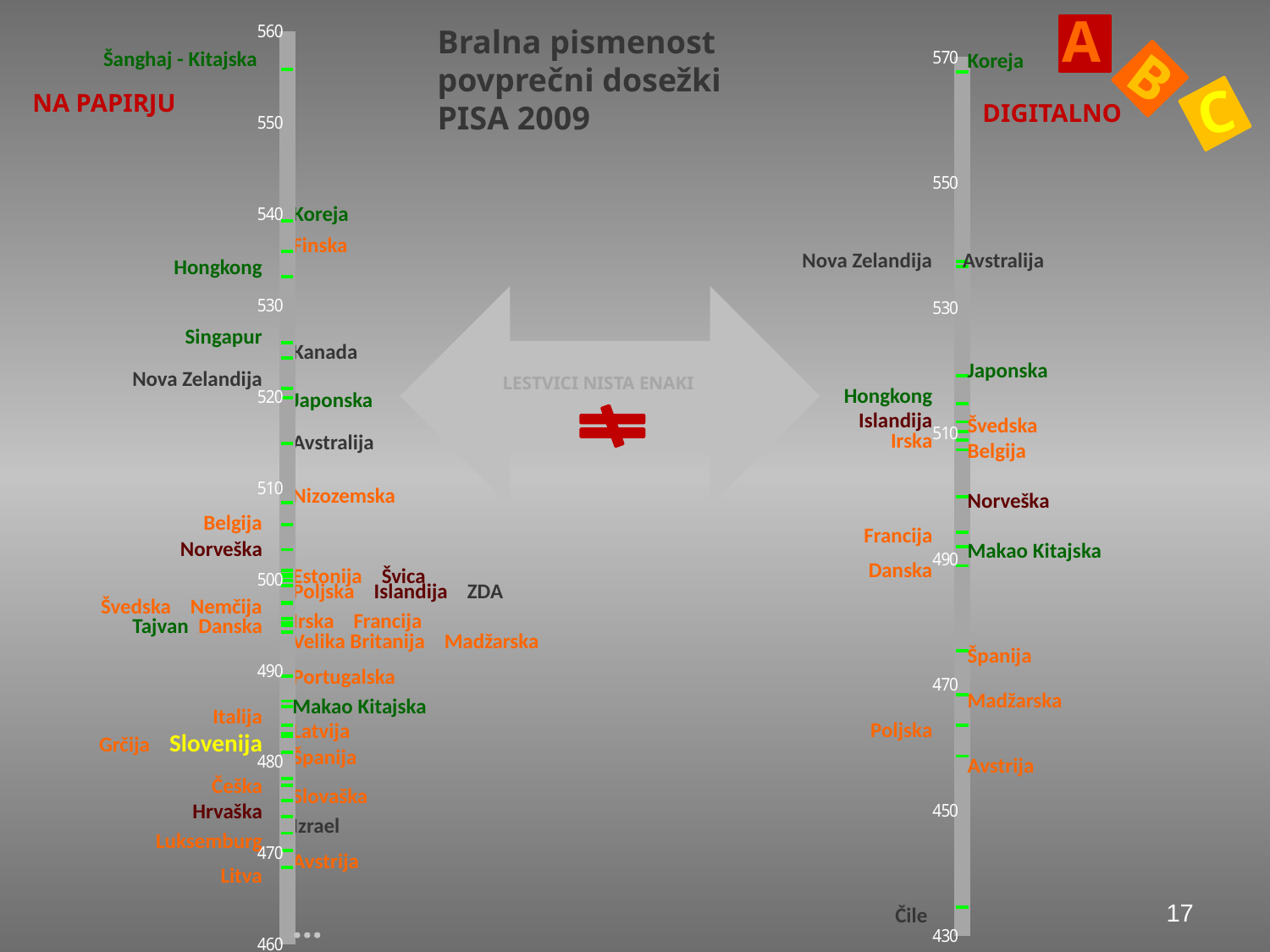
On the NA PAPIRJU scale, which is placed higher, Koreja or Avstralija? Koreja On the NA PAPIRJU scale, is the value for Slovenija greater or less than 490? less On the NA PAPIRJU scale, is the value for Hongkong greater or less than 530? greater How many scales (charts) are shown on the slide? 2 On the DIGITALNO scale, which country is placed lowest? Čile On the DIGITALNO scale, is the value for Koreja greater or less than 550? greater On the DIGITALNO scale, which country is placed highest? Koreja On the NA PAPIRJU scale, which country is placed highest? Šanghaj - Kitajska What text is written in the arrow between the two scales? LESTVICI NISTA ENAKI What is the title of the chart on the slide? Bralna pismenost povprečni dosežki PISA 2009